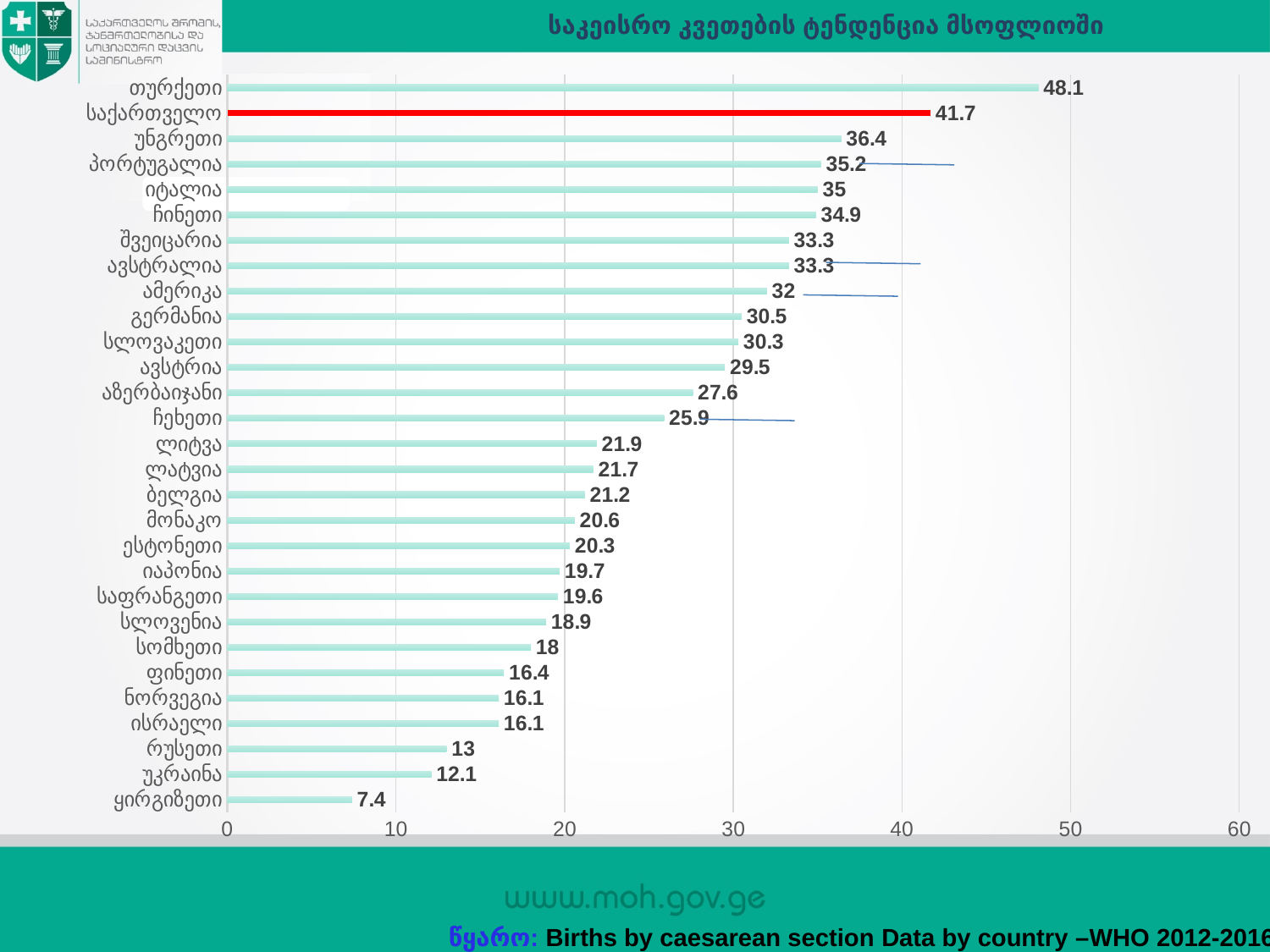
What is the difference between the values for თურქეთი and საქართველო? 6.4 How many countries are shown in the chart? 29 What is the value for საქართველო? 41.7 Which has a larger value, უნგრეთი or გერმანია? უნგრეთი What is the value for ყირგიზეთი? 7.4 Which country has the lowest value? ყირგიზეთი Is the value for ჩეხეთი greater or less than 30? less Which bar is highlighted in red? საქართველო What is the value for აზერბაიჯანი? 27.6 What kind of chart is shown on the slide? bar chart Which country has the highest value? თურქეთი What is the value for თურქეთი? 48.1